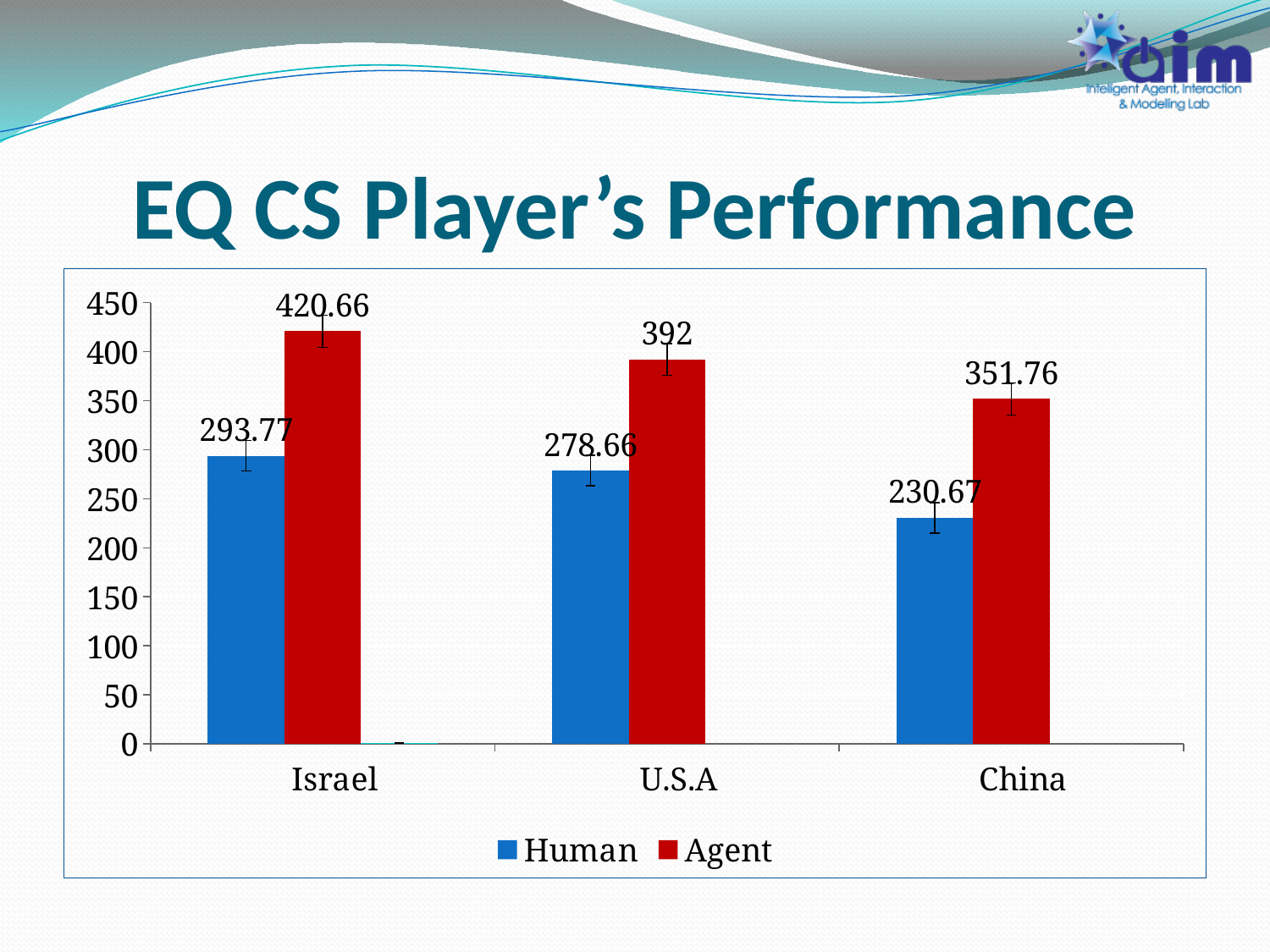
What is the difference between the Agent and Human values for Israel? 126.89 What kind of chart is shown on the slide? Bar chart Do the Human values rise or fall from Israel to China? Fall Which country has the highest Agent value? Israel Which country has the lowest Human value? China What is the Agent value for U.S.A? 392 What is the Agent value for China? 351.76 What is the Human value for China? 230.67 What is the Human value for Israel? 293.77 How many series does the legend list? 2 How many countries are shown on the x axis? 3 Which is larger for U.S.A, the Human value or the Agent value? Agent